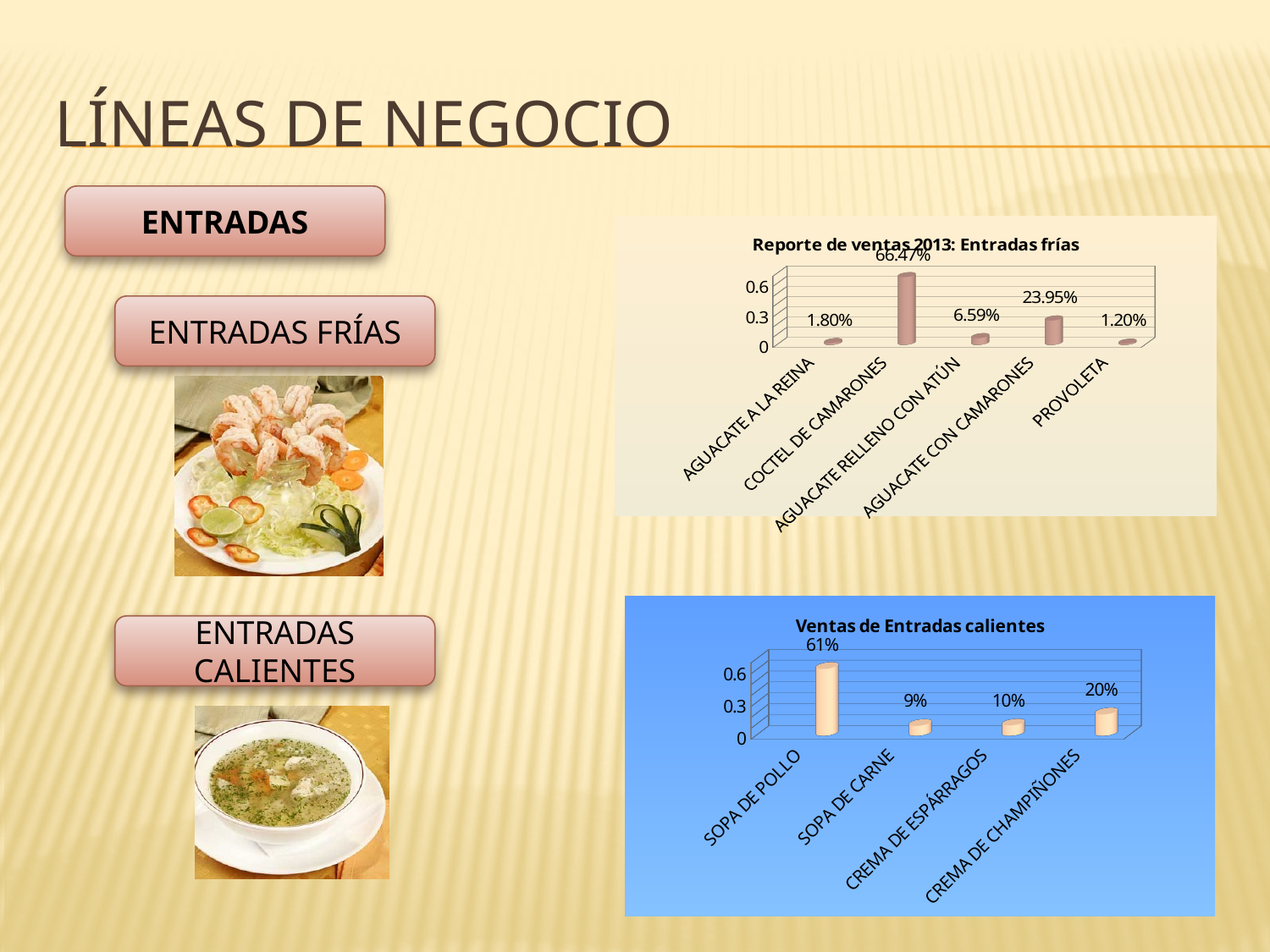
In the chart 'Reporte de ventas 2013: Entradas frías', which category has the lowest value? PROVOLETA In the chart 'Ventas de Entradas calientes', what is the value for SOPA DE POLLO? 61% In the chart 'Ventas de Entradas calientes', what is the value for CREMA DE CHAMPIÑONES? 20% In the chart 'Reporte de ventas 2013: Entradas frías', what is the value for AGUACATE CON CAMARONES? 23.95% What kind of chart is 'Ventas de Entradas calientes'? Bar chart In the chart 'Reporte de ventas 2013: Entradas frías', what is the value for COCTEL DE CAMARONES? 66.47% In the chart 'Reporte de ventas 2013: Entradas frías', how many categories are shown? 5 In the chart 'Ventas de Entradas calientes', how many categories are shown? 4 In the chart 'Ventas de Entradas calientes', which category has the lowest value? SOPA DE CARNE In the chart 'Reporte de ventas 2013: Entradas frías', what is the difference between AGUACATE RELLENO CON ATÚN and AGUACATE A LA REINA? 4.79% In the chart 'Reporte de ventas 2013: Entradas frías', which category has the highest value? COCTEL DE CAMARONES In the chart 'Ventas de Entradas calientes', which is larger, CREMA DE ESPÁRRAGOS or CREMA DE CHAMPIÑONES? CREMA DE CHAMPIÑONES